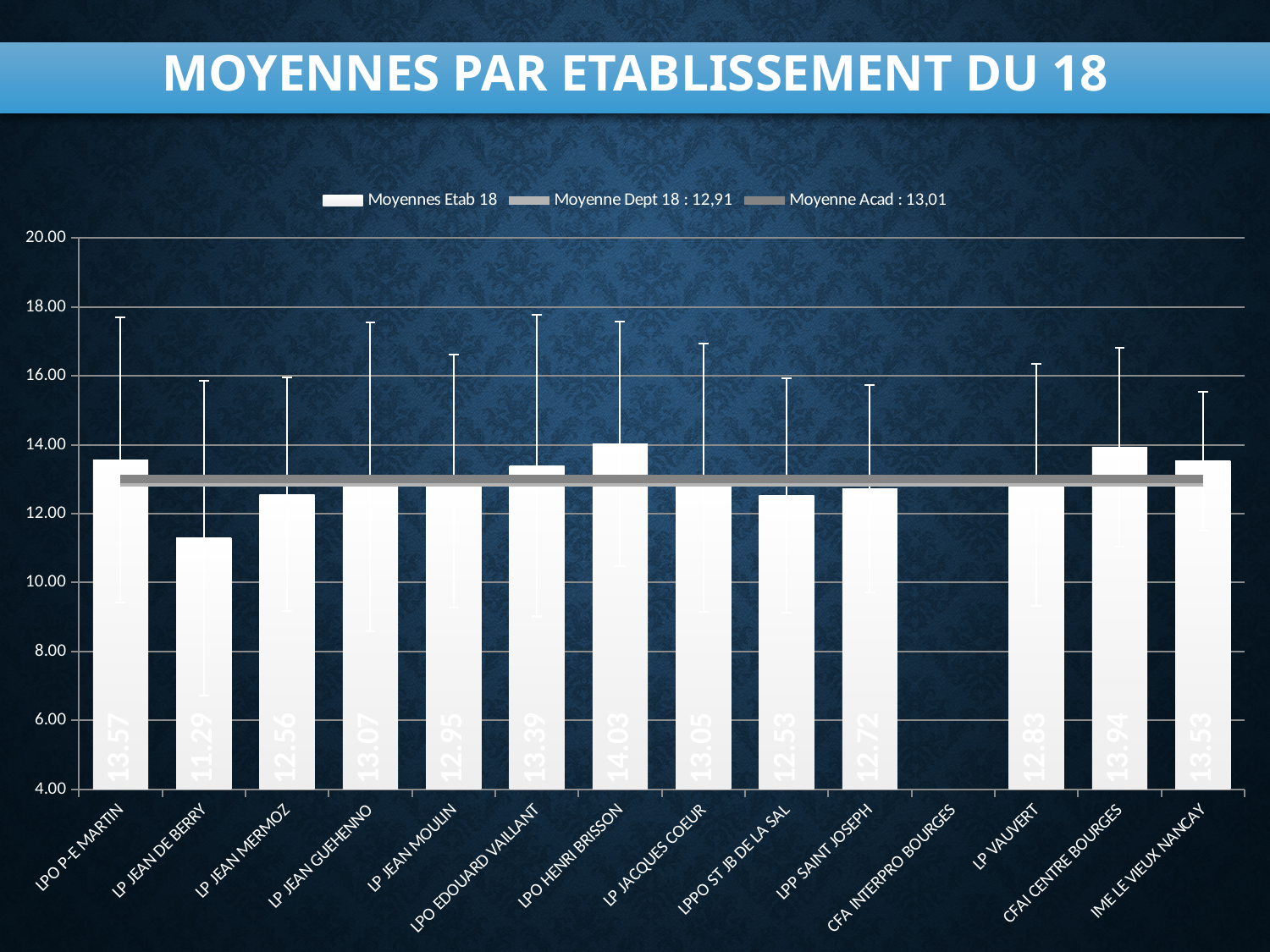
What kind of chart is shown? bar chart What is the value for CFAI CENTRE BOURGES? 13.94 How many establishments are listed on the x axis? 14 How many series does the legend list? 3 What is the difference between the values for LPO HENRI BRISSON and LP JEAN DE BERRY? 2.74 Which establishment has the lowest value? LP JEAN DE BERRY What value does the legend give for Moyenne Dept 18? 12,91 Which establishment has the highest value? LPO HENRI BRISSON What is the value for LP JEAN DE BERRY? 11.29 What is the value for LPO HENRI BRISSON? 14.03 Which is larger, the value for LPO P-E MARTIN or the value for CFAI CENTRE BOURGES? CFAI CENTRE BOURGES What is the value for LPP SAINT JOSEPH? 12.72